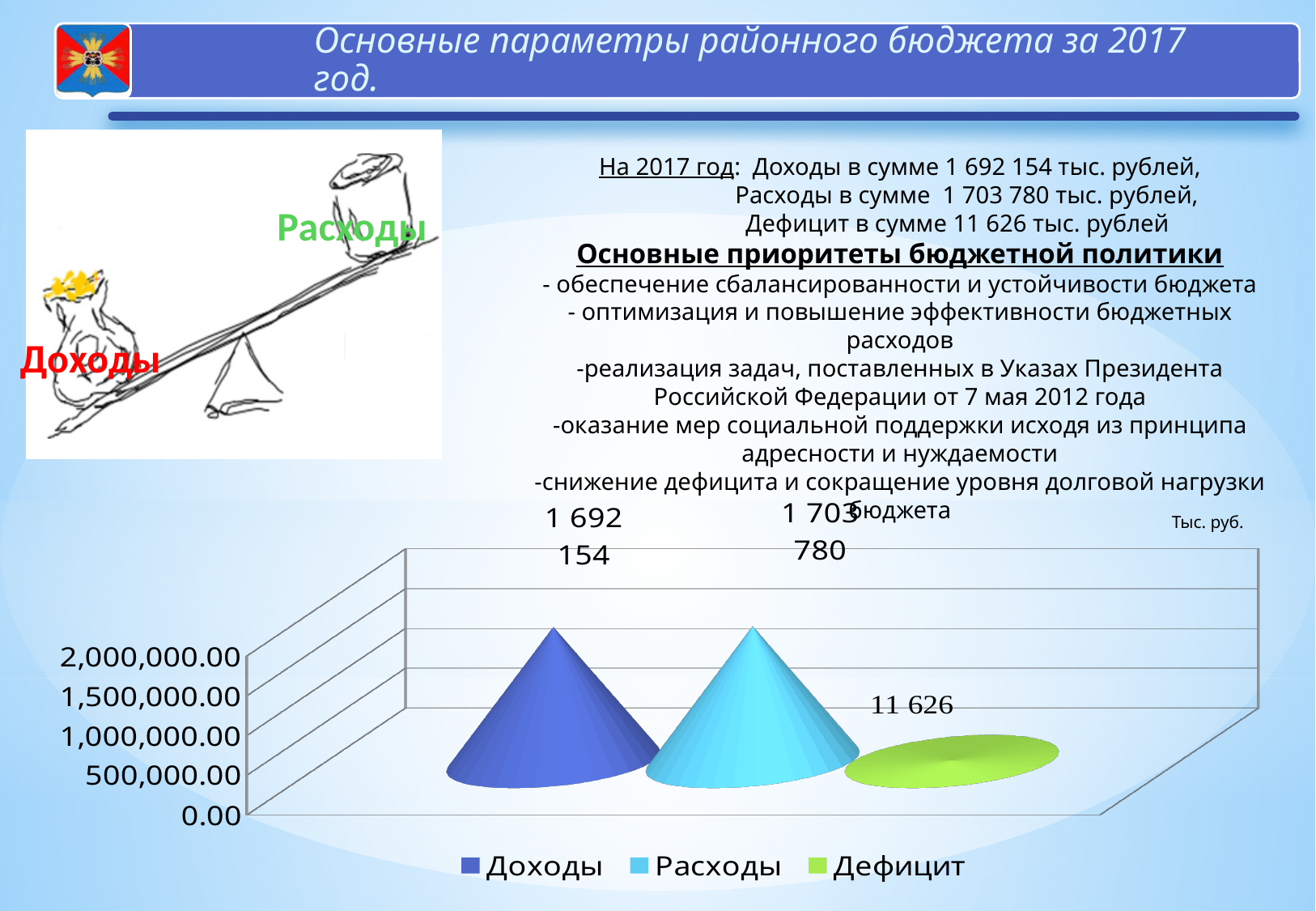
How many series does the chart legend list? 3 What is the value for Расходы in the chart? 1 703 780 Which series has the lowest value in the chart? Дефицит What unit label is shown at the top right of the chart? Тыс. руб. What is the difference between the values for Расходы and Доходы in the chart? 11 626 Which is larger in the chart, Доходы or Расходы? Расходы Which series has the highest value in the chart? Расходы What kind of chart is shown on the slide? bar chart Is the value for Дефицит greater or less than 500,000.00? less Is the value for Доходы greater or less than 1,500,000.00? greater What is the value for Дефицит in the chart? 11 626 What is the value for Доходы in the chart? 1 692 154